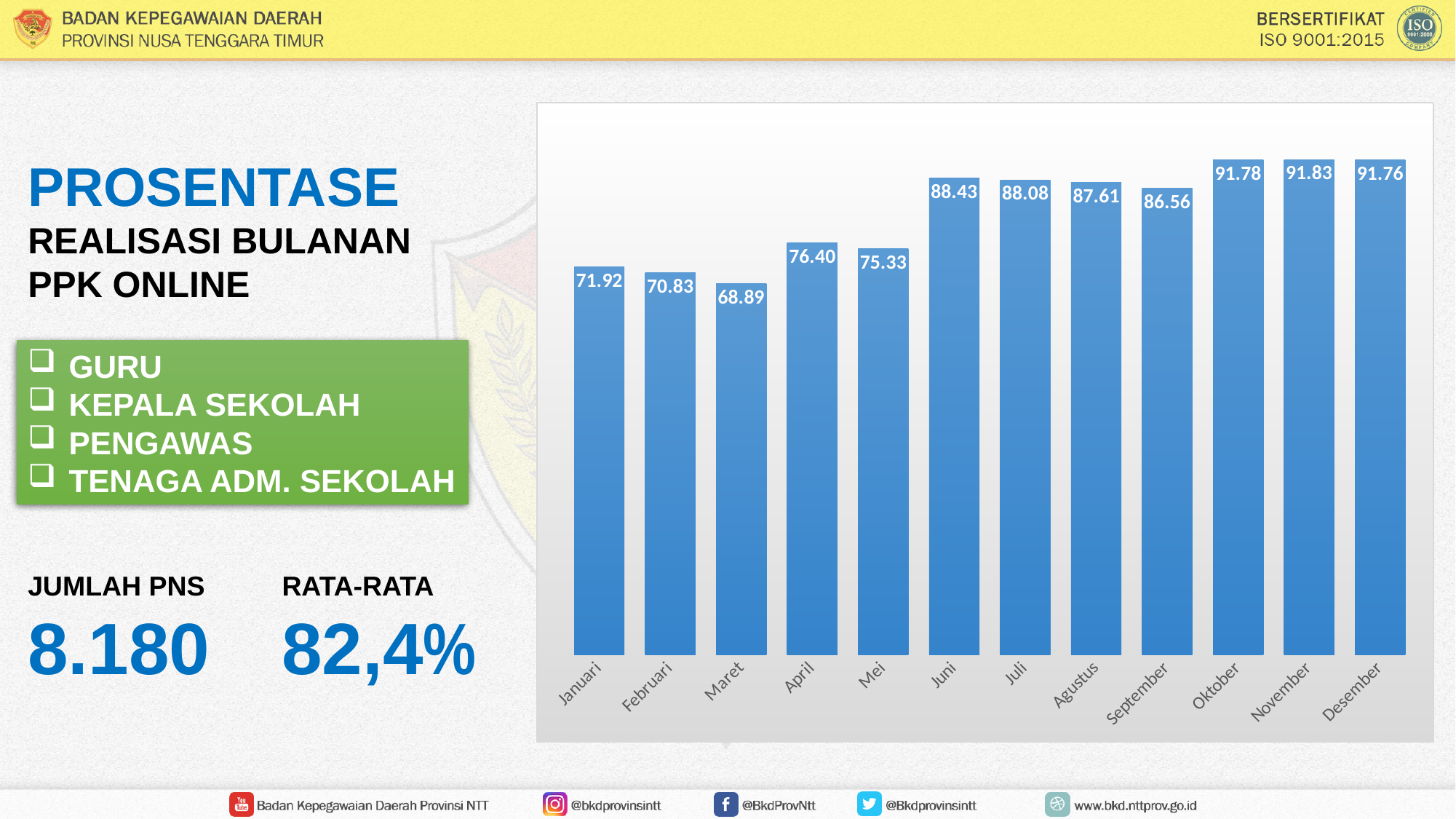
Which month has the highest value? November What is the value for Desember? 91.76 What kind of chart is shown on the slide? Bar chart Which month has the lowest value? Maret What is the value for September? 86.56 What is the difference between the values for Juni and Januari? 16.51 Do the values generally rise or fall from Januari to Desember? Rise What is the value for Juni? 88.43 Which is larger, the value for April or the value for Mei? April What is the difference between the values for Oktober and September? 5.22 How many months are shown on the chart? 12 What is the value for Januari? 71.92